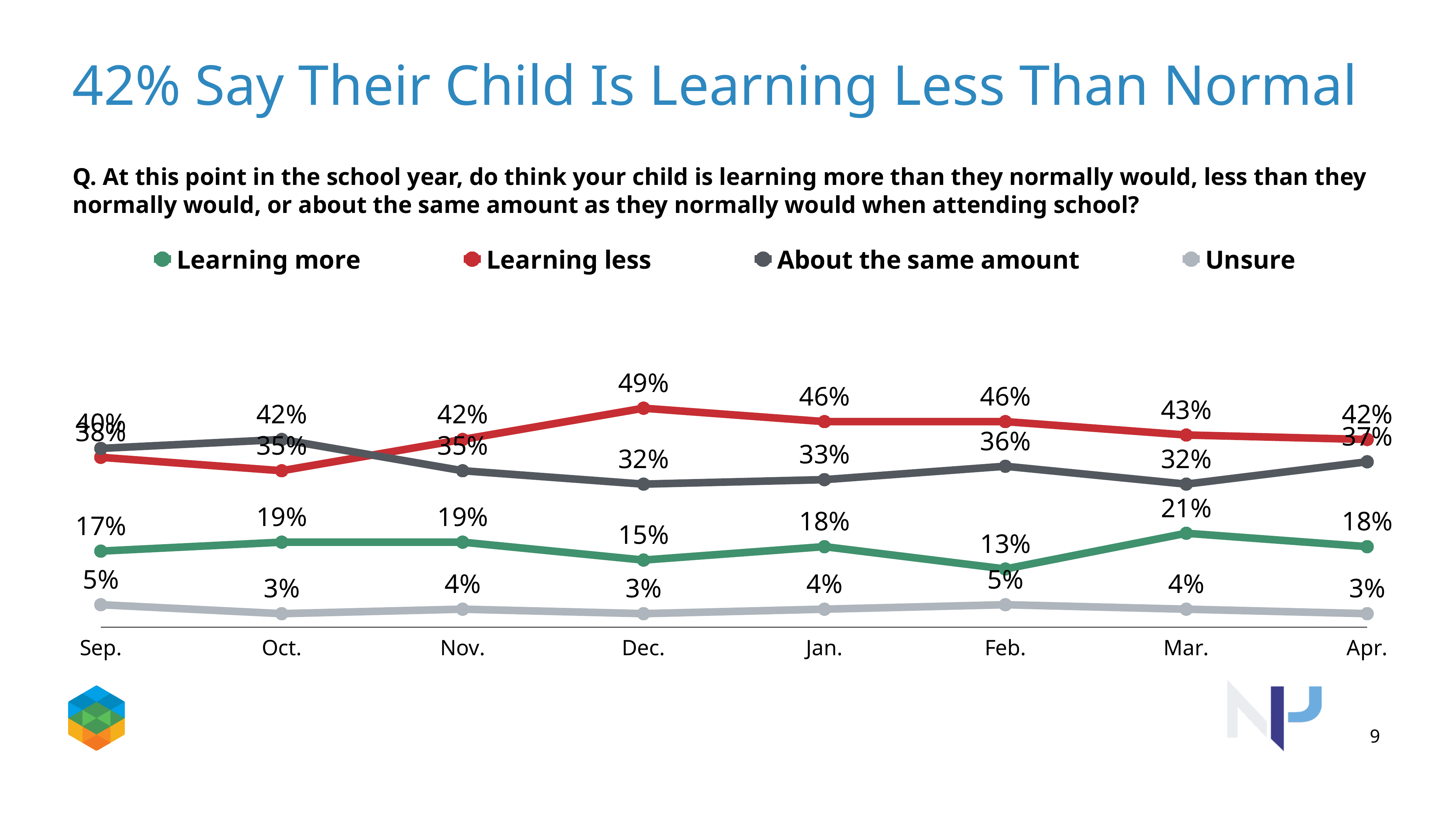
In which month is Learning more at its lowest? Feb. What is the value for Unsure in Jan.? 4% What is the value for Learning less in Dec.? 49% How many series does the legend list? 4 In which month is Learning less at its highest? Dec. Which series is shown in red? Learning less How many months are plotted along the x axis? 8 Which is larger in Oct., Learning less or About the same amount? About the same amount What is the value for About the same amount in Feb.? 36% What is the difference between Learning less and About the same amount in Dec.? 17 percentage points What kind of chart is shown on the slide? line chart What is the value for Learning more in Mar.? 21%